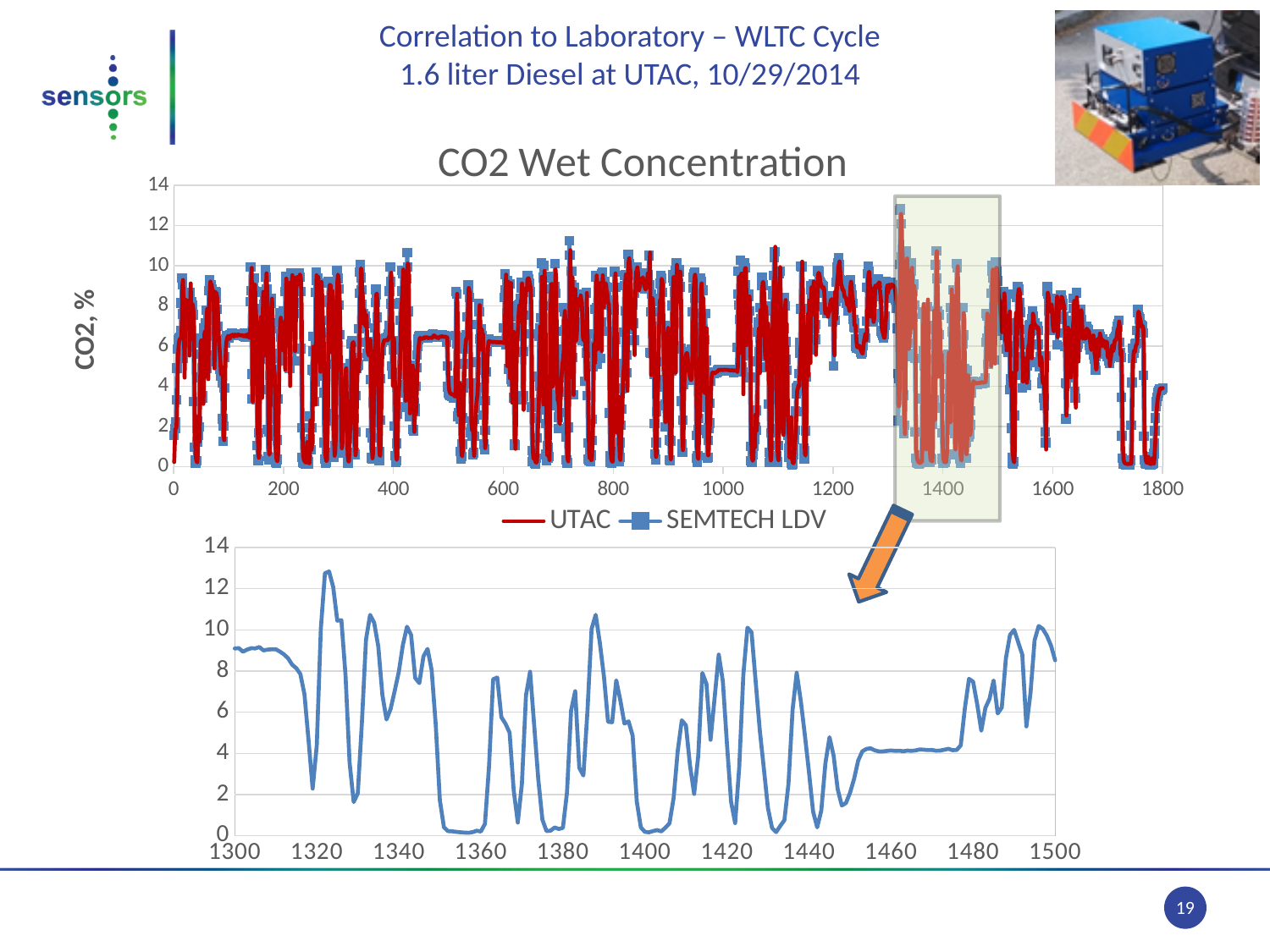
What kind of chart is the top chart titled 'CO2 Wet Concentration'? line chart In the top chart 'CO2 Wet Concentration', is the value at 1800 greater or less than 6? less In the bottom chart (x axis 1300 to 1500), is the value at 1360 greater or less than 2? less What kind of chart is the bottom chart with the x axis from 1300 to 1500? line chart In the bottom chart (x axis 1300 to 1500), is the value at 1300 greater or less than 8? greater How many series does the legend of the top chart 'CO2 Wet Concentration' list? 2 What is the y-axis label of the top chart 'CO2 Wet Concentration'? CO2, % What are the two series named in the legend of the top chart 'CO2 Wet Concentration'? UTAC and SEMTECH LDV